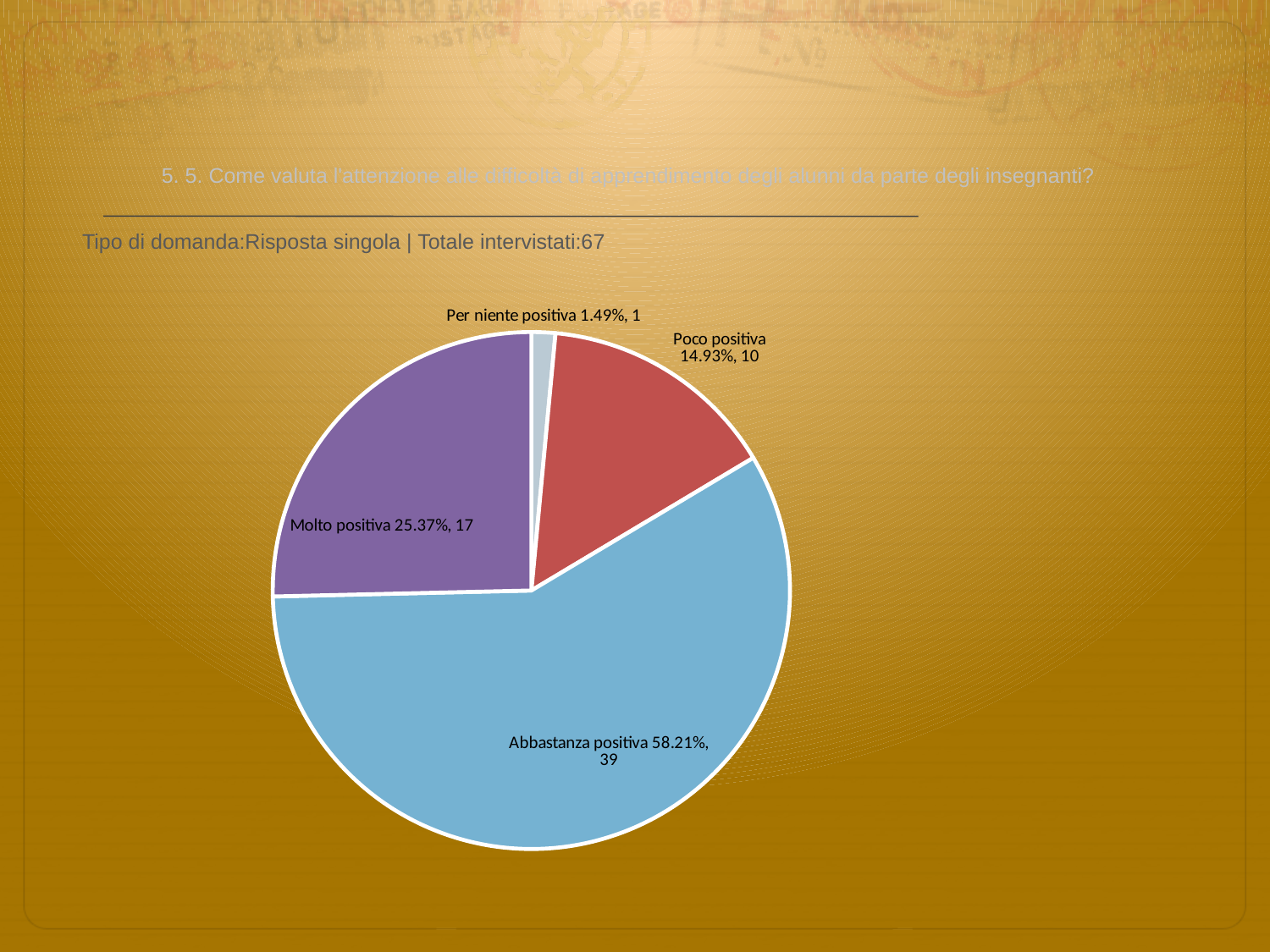
What kind of chart is shown on the slide? pie chart How many respondents chose 'Molto positiva'? 17 What percentage share does the 'Per niente positiva' slice have? 1.49% Which category has the largest slice of the pie? Abbastanza positiva What is the difference in respondent count between 'Abbastanza positiva' and 'Molto positiva'? 22 How many respondents chose 'Poco positiva'? 10 What colour is the 'Molto positiva' slice? purple What percentage share does the 'Abbastanza positiva' slice have? 58.21% Which category has the smallest slice of the pie? Per niente positiva Which has more respondents, 'Molto positiva' or 'Poco positiva'? Molto positiva How many slices does the pie chart have? 4 What is the total number of respondents shown on the slide? 67